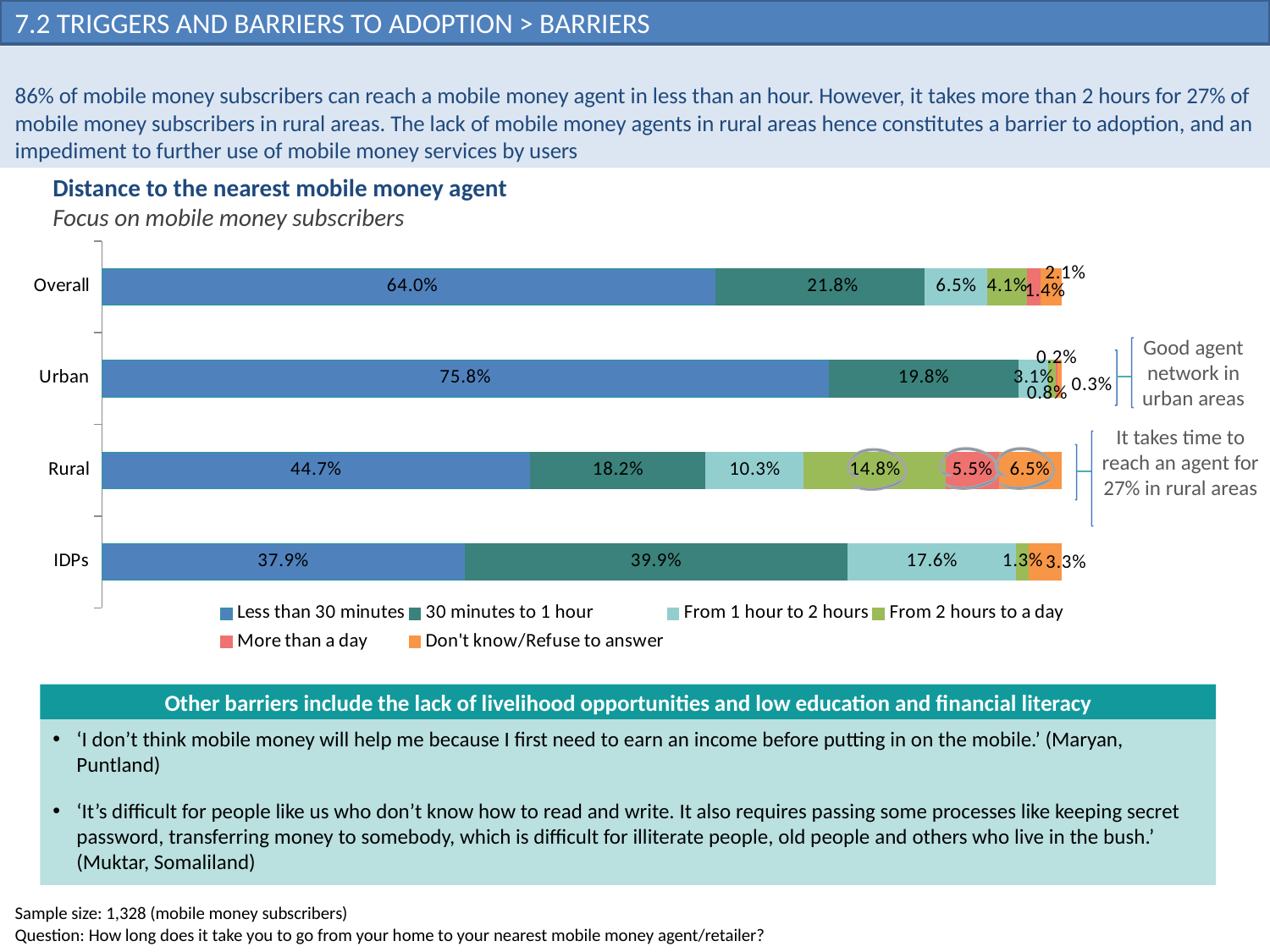
Which category has the highest share of subscribers less than 30 minutes from an agent? Urban What is the value for 'More than a day' in the Rural category? 5.5% How many series does the chart legend list? 6 Which has a larger 'From 1 hour to 2 hours' share, Rural or IDPs? IDPs What share of Urban subscribers are less than 30 minutes from the nearest mobile money agent? 75.8% What percentage of Overall mobile money subscribers can reach an agent in less than 30 minutes? 64.0% What type of chart is used to show distance to the nearest mobile money agent? Stacked bar chart Which category has the lowest share of subscribers less than 30 minutes from an agent? IDPs What is the value for 'From 2 hours to a day' in the Rural category? 14.8% What is the value for '30 minutes to 1 hour' for IDPs? 39.9% How many categories are shown on the vertical axis of the chart? 4 How many percentage points higher is the 'Less than 30 minutes' share for Urban than for Rural? 31.1 percentage points